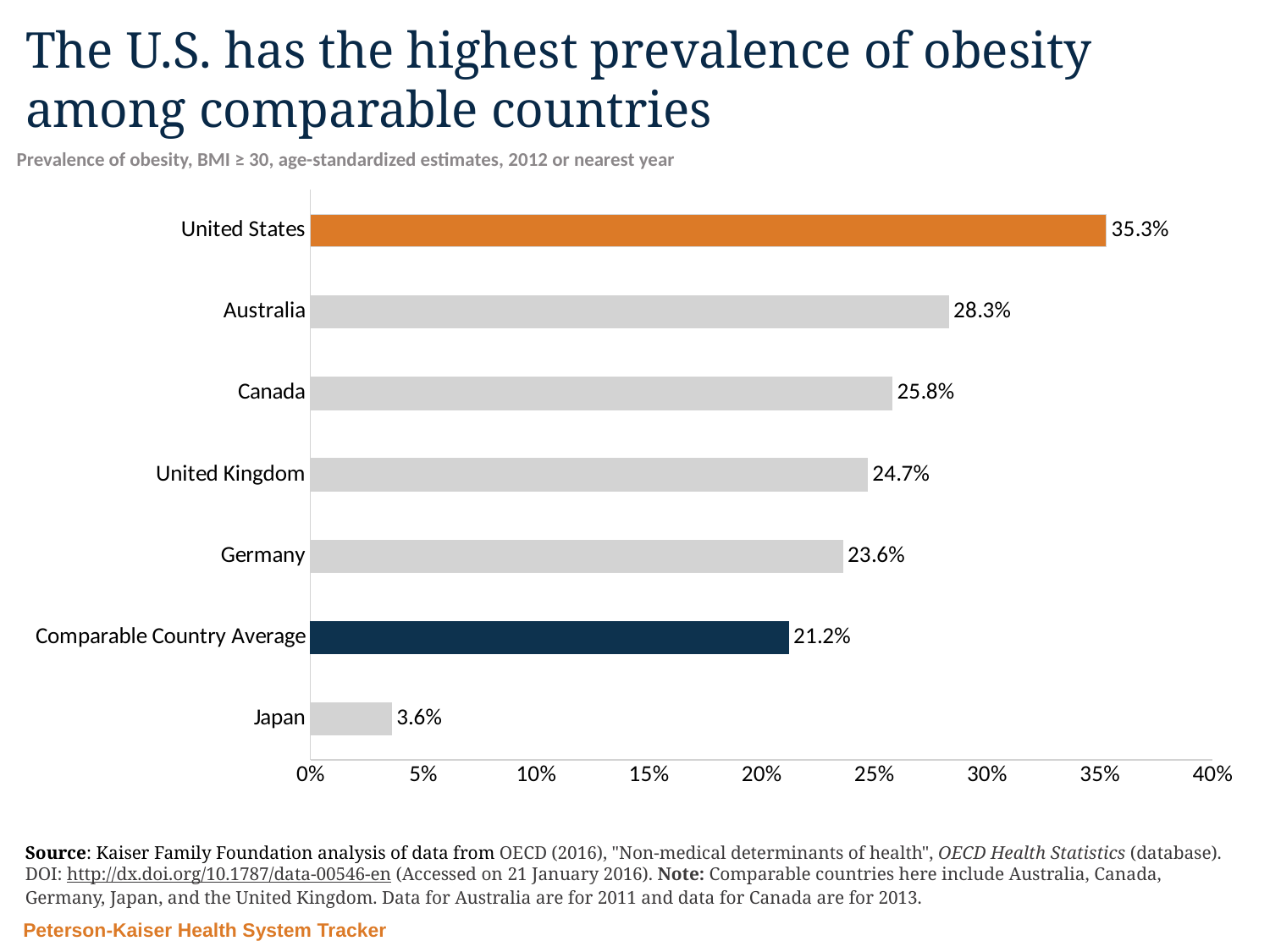
How many bars are shown in the chart? 7 What is the prevalence of obesity for the United States? 35.3% Which country has the lowest prevalence of obesity? Japan What is the value for the Comparable Country Average? 21.2% What is the difference between Australia and Canada? 2.5% Which country has the highest prevalence of obesity? United States What is the difference between the United States and the Comparable Country Average? 14.1% Is the value for Canada greater or less than 25%? greater Which has a higher prevalence of obesity, the United Kingdom or Germany? United Kingdom Which bar is coloured orange? United States What kind of chart is shown on the slide? Bar chart What is the prevalence of obesity for Japan? 3.6%